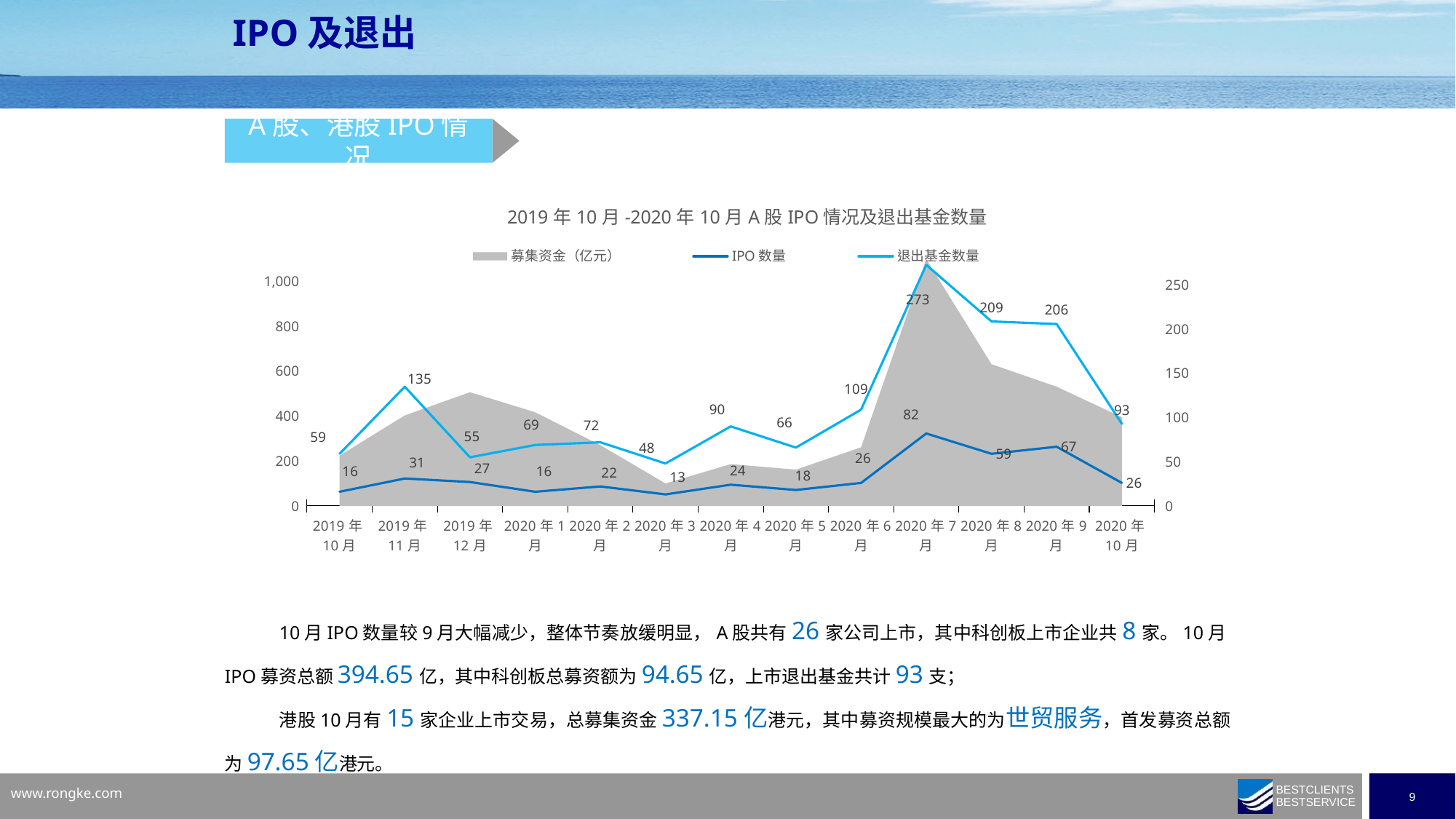
How many series does the chart's legend list? 3 Which month has the larger IPO 数量, 2020年8月 or 2020年9月? 2020年9月 Is the 募集资金（亿元） value for 2020年7月 greater or less than 800? greater Does the 退出基金数量 rise or fall from 2020年7月 to 2020年10月? fall What is the 退出基金数量 value for 2020年10月? 93 In which month is the 退出基金数量 highest? 2020年7月 In which month is the IPO 数量 lowest? 2020年3月 What is the 退出基金数量 value for 2019年11月? 135 What is the difference between the 退出基金数量 values for 2020年8月 and 2020年9月? 3 What is the IPO 数量 value for 2020年7月? 82 How many months are shown on the x axis of the chart? 13 Which series is shown as the gray shaded area in the chart? 募集资金（亿元）